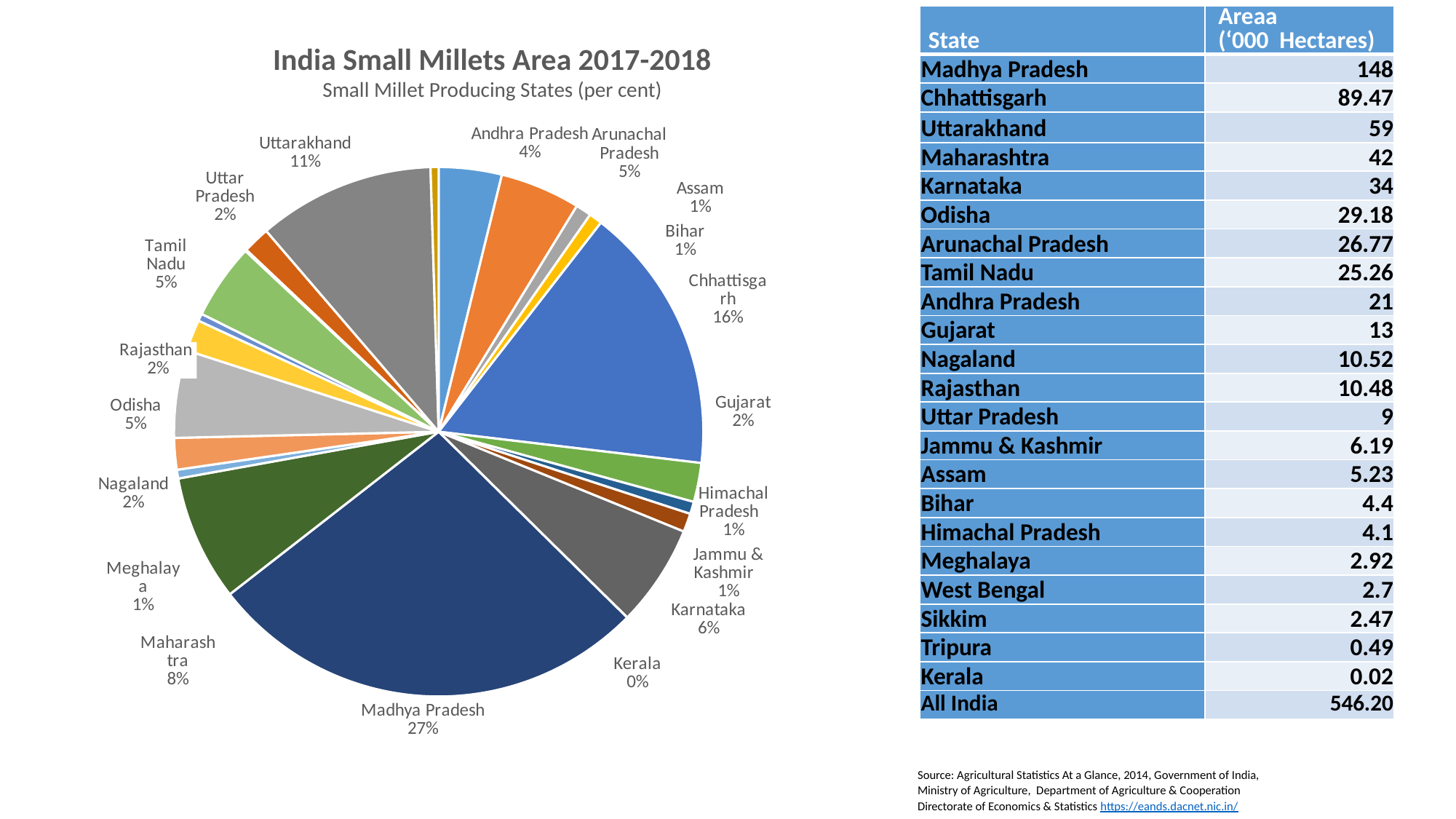
What share of the pie does Madhya Pradesh hold? 27% What kind of chart is shown on the slide? pie chart What is the title of the chart? India Small Millets Area 2017-2018 What percentage is shown for Karnataka? 6% What percentage is shown for Uttarakhand? 11% What percentage is shown for Kerala? 0% Which state has the largest share of the pie? Madhya Pradesh What is the subtitle shown below the chart title? Small Millet Producing States (per cent) What is the difference in percentage points between Madhya Pradesh and Chhattisgarh? 11 What share of the pie does Chhattisgarh hold? 16% Which labelled state has the smallest share of the pie? Kerala Which has the larger share, Uttarakhand or Maharashtra? Uttarakhand